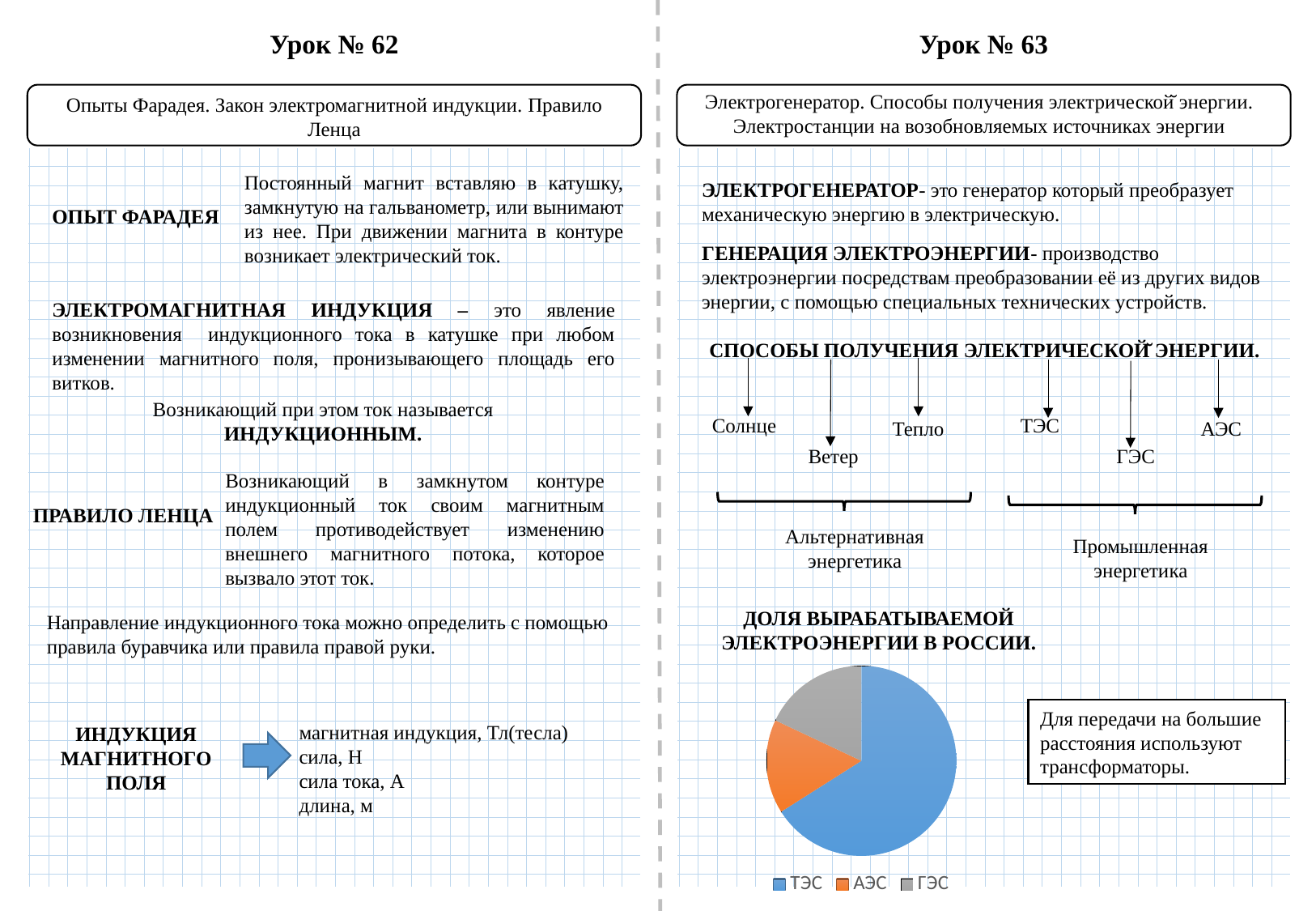
What are the three categories listed in the pie chart's legend? ТЭС, АЭС, ГЭС How many entries does the legend of the pie chart list? 3 In the pie chart, which slice is larger: ТЭС or ГЭС? ТЭС In the pie chart, which slice is larger: ТЭС or АЭС? ТЭС Which category has the largest slice in the pie chart? ТЭС What kind of chart is shown under the heading "ДОЛЯ ВЫРАБАТЫВАЕМОЙ ЭЛЕКТРОЭНЕРГИИ В РОССИИ"? pie chart Which category is shown in blue in the pie chart? ТЭС How many slices does the pie chart on the slide have? 3